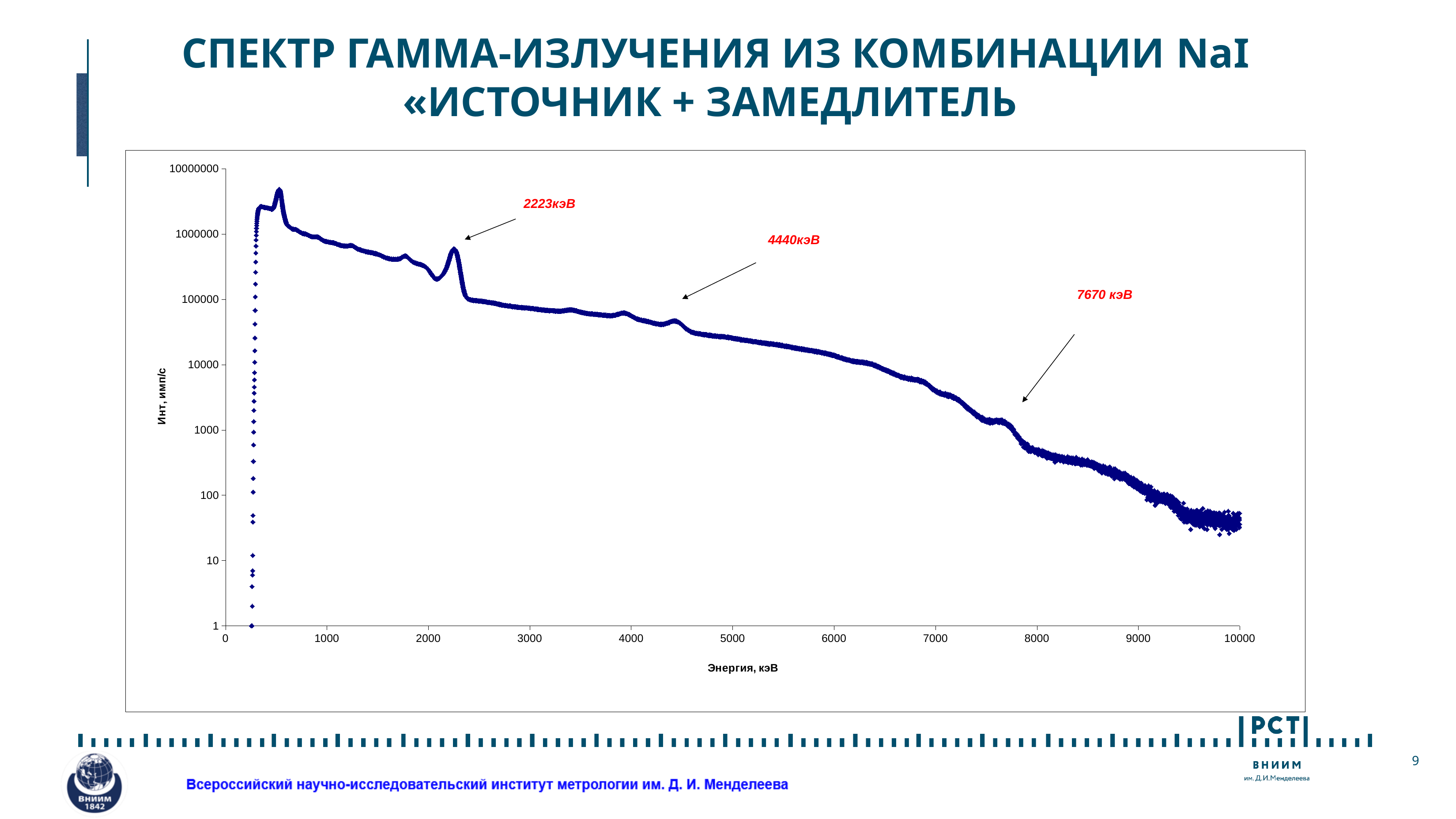
Is the value at 500 keV greater or less than 1000000? greater What is the label of the x axis of the chart? Энергия, кэВ How many energy peaks are annotated with red labels on the chart? 3 Is the value at 10000 keV greater or less than 100? less Is the value at 3000 keV greater or less than 100000? less Overall, do the values rise or fall as energy increases from 1000 to 10000 keV? fall What is the label of the y axis of the chart? Инт, имп/с What is the highest tick value shown on the x axis? 10000 What kind of chart is shown on the slide? scatter chart What is the highest tick value shown on the y axis? 10000000